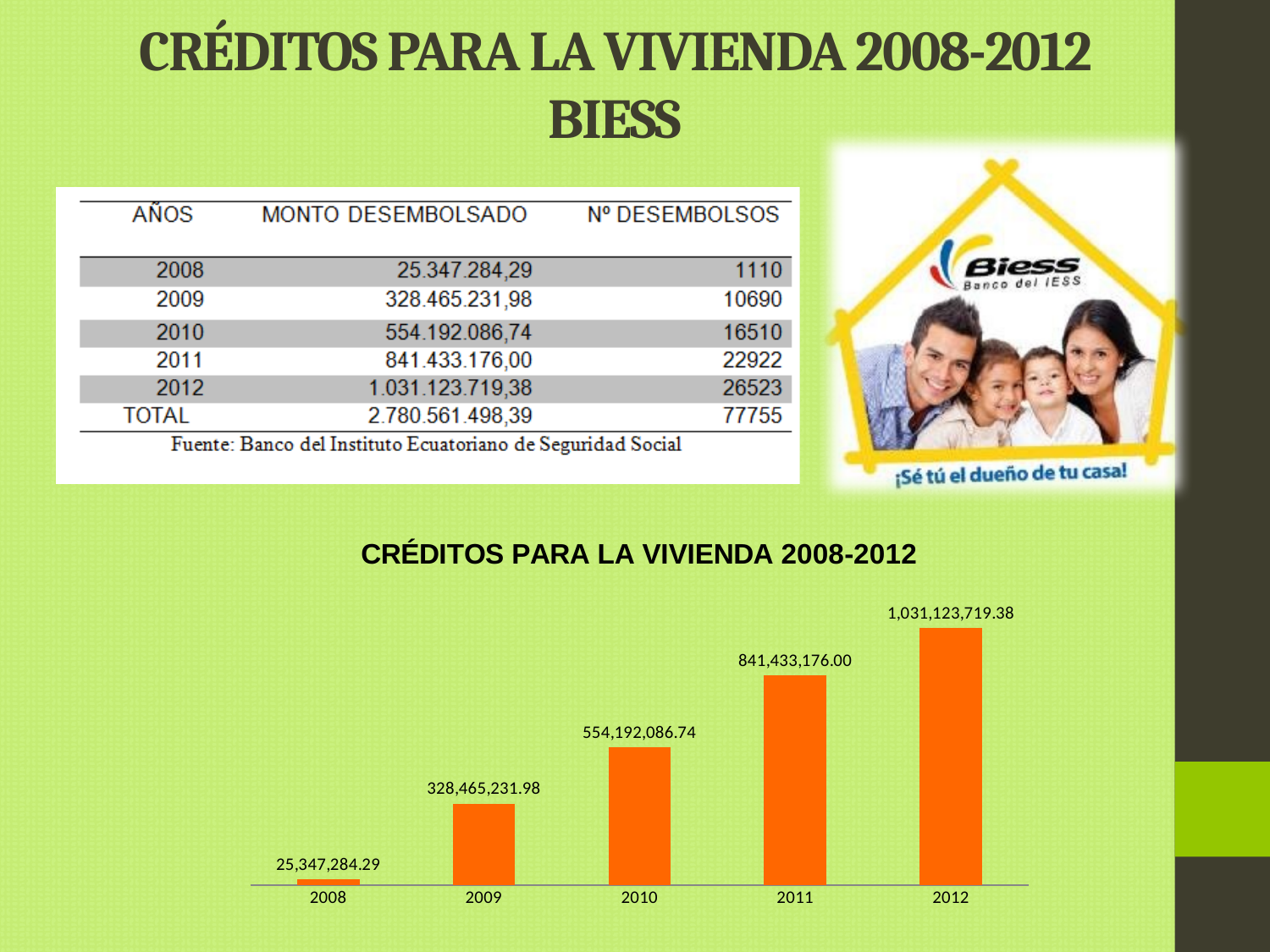
What is the value shown for 2010 in the chart? 554,192,086.74 What is the value shown for 2008 in the chart? 25,347,284.29 Which year has the highest value in the chart? 2012 What kind of chart is shown on the slide? Bar chart What is the difference between the values for 2011 and 2010? 287,241,089.26 What is the value shown for 2009 in the chart? 328,465,231.98 Which year has the lowest value in the chart? 2008 Do the values rise or fall from 2008 to 2012? Rise How many years are shown on the x axis of the chart? 5 Which is larger, the value for 2009 or the value for 2011? 2011 What is the value shown for 2012 in the chart? 1,031,123,719.38 What is the difference between the values for 2012 and 2011? 189,690,543.38